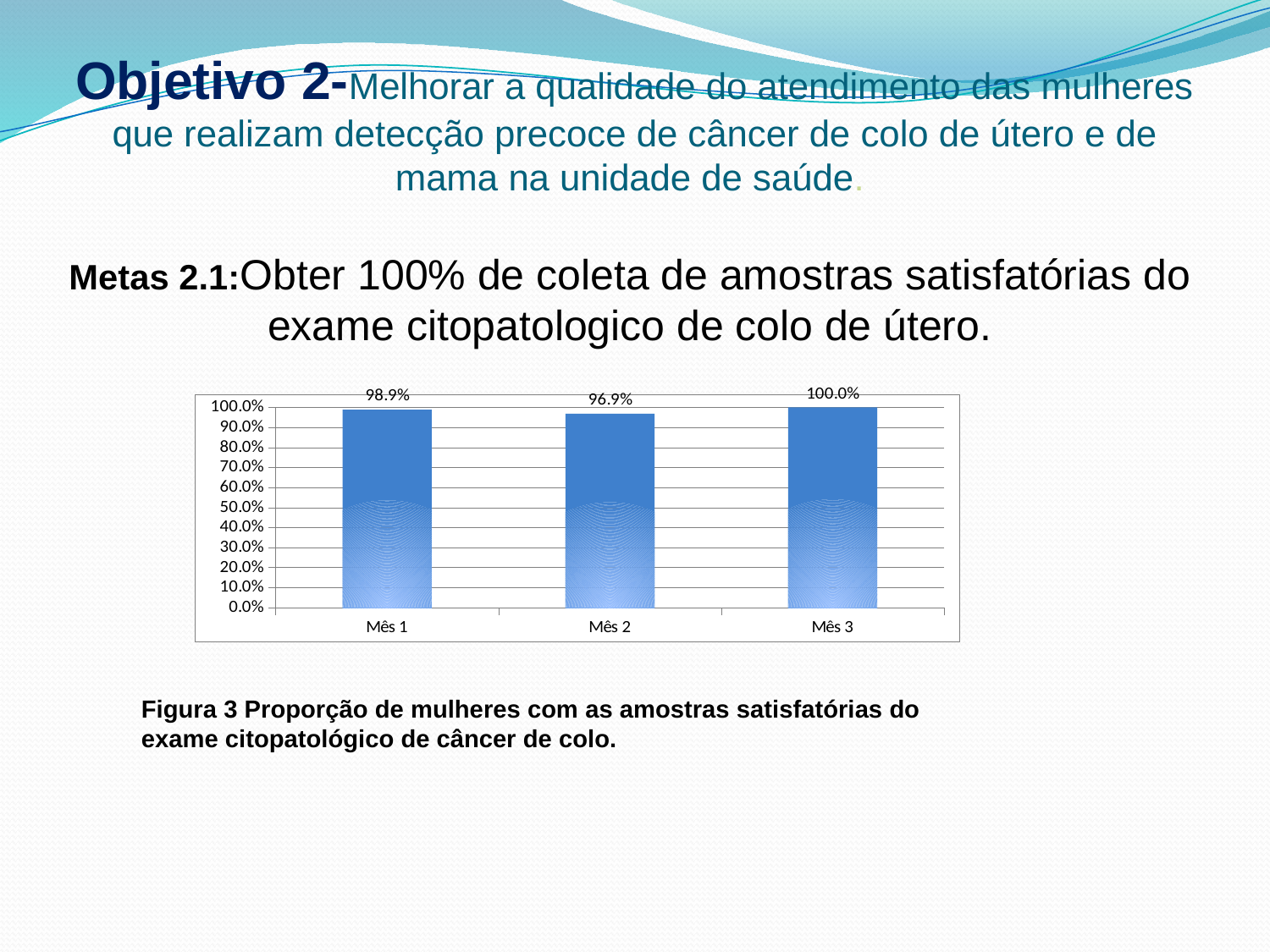
Which month has the highest value? Mês 3 What is the value for Mês 2? 96.9% What is the difference between the values for Mês 1 and Mês 2? 2.0% What is the difference between the values for Mês 3 and Mês 2? 3.1% What kind of chart is shown on the slide? Bar chart Which month has the lowest value? Mês 2 Which is larger, the value for Mês 1 or the value for Mês 2? Mês 1 How many months are shown on the x axis of the chart? 3 What is the figure number given in the caption below the chart? Figura 3 Is the value for Mês 2 greater or less than 90.0%? greater What is the value for Mês 3? 100.0% What is the value for Mês 1? 98.9%